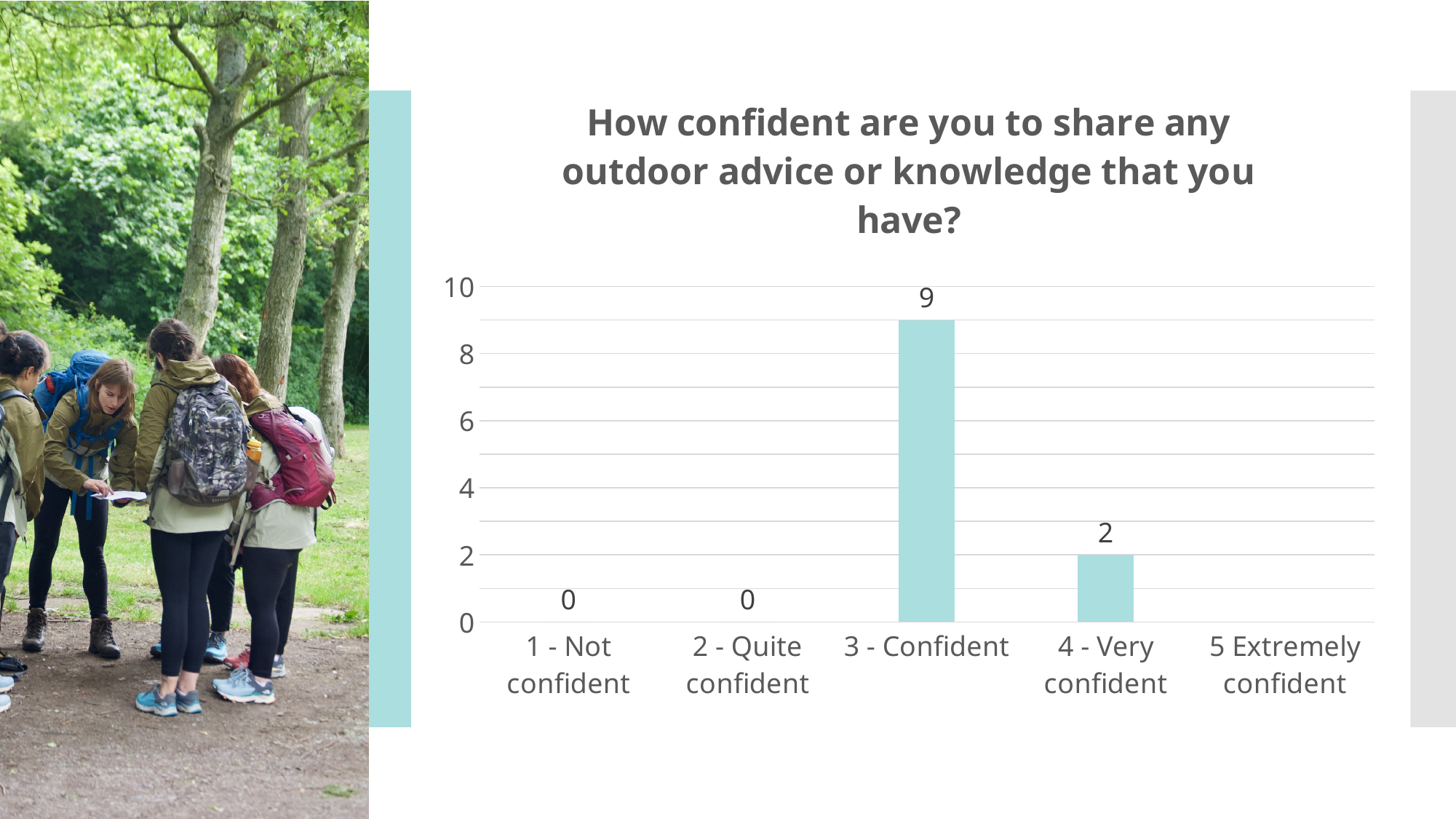
What is the value for "3 - Confident"? 9 What is the value for "4 - Very confident"? 2 What is the title of the chart? How confident are you to share any outdoor advice or knowledge that you have? What is the difference between the values for "3 - Confident" and "4 - Very confident"? 7 Which is larger, the value for "3 - Confident" or the value for "4 - Very confident"? 3 - Confident What is the value for "1 - Not confident"? 0 Which category has the highest value? 3 - Confident What is the value for "2 - Quite confident"? 0 How many categories are shown on the x axis? 5 Is the value for "3 - Confident" greater or less than 8? greater What kind of chart is shown on the slide? bar chart What is the highest value shown on the y axis? 10